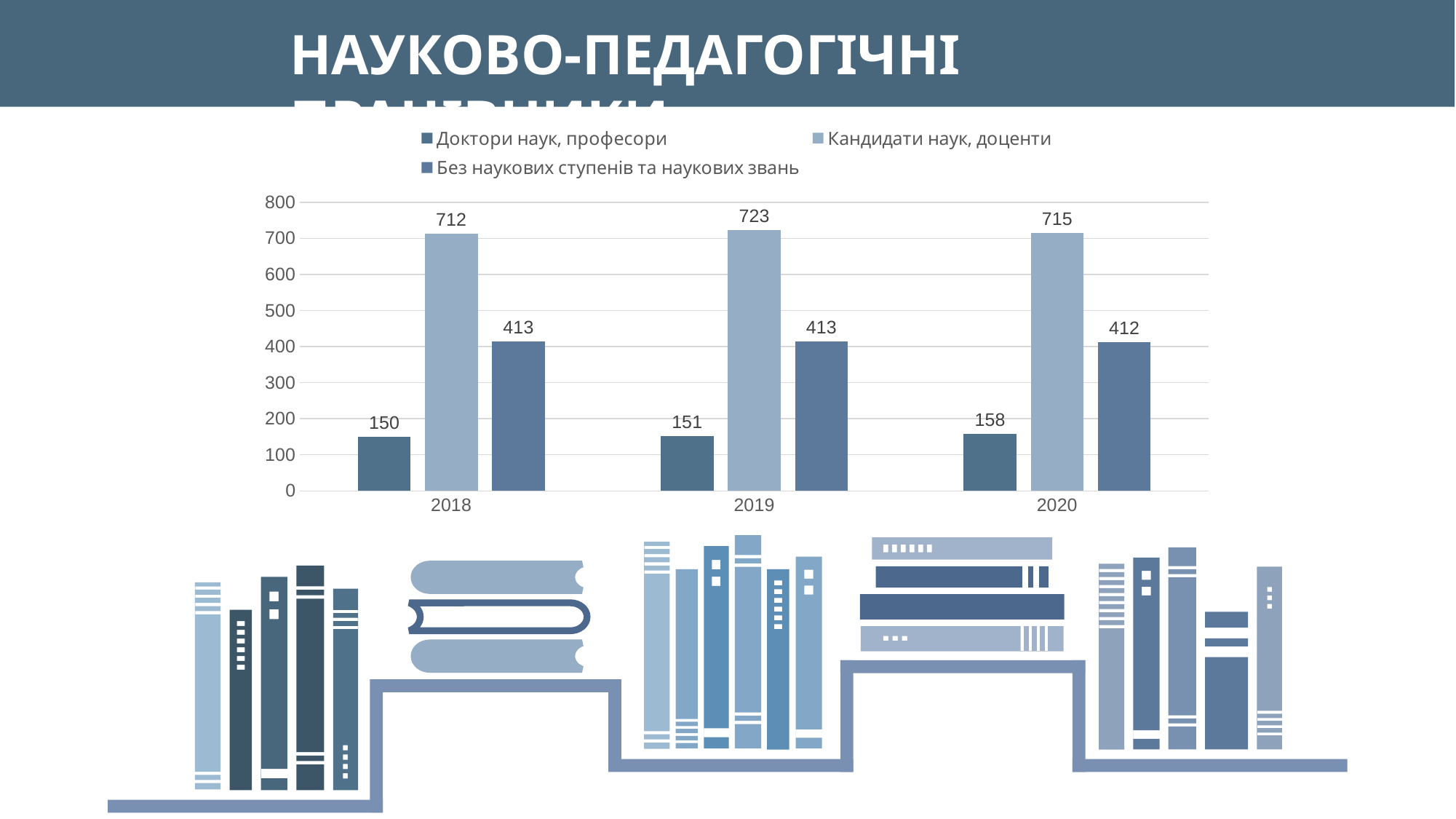
Does the value for "Доктори наук, професори" rise or fall from 2018 to 2020? Rise Which series has the larger value in 2019: "Без наукових ступенів та наукових звань" or "Доктори наук, професори"? Без наукових ступенів та наукових звань What is the value for "Без наукових ступенів та наукових звань" in 2018? 413 What kind of chart is shown on the slide? Bar chart In which year is the value for "Доктори наук, професори" the lowest? 2018 What is the value for "Кандидати наук, доценти" in 2019? 723 How many years are shown on the x axis? 3 What is the difference between the "Кандидати наук, доценти" value and the "Доктори наук, професори" value in 2020? 557 What is the total of the three series values in 2018? 1275 How many series does the legend list? 3 In which year is the value for "Кандидати наук, доценти" the highest? 2019 What is the value for "Доктори наук, професори" in 2020? 158